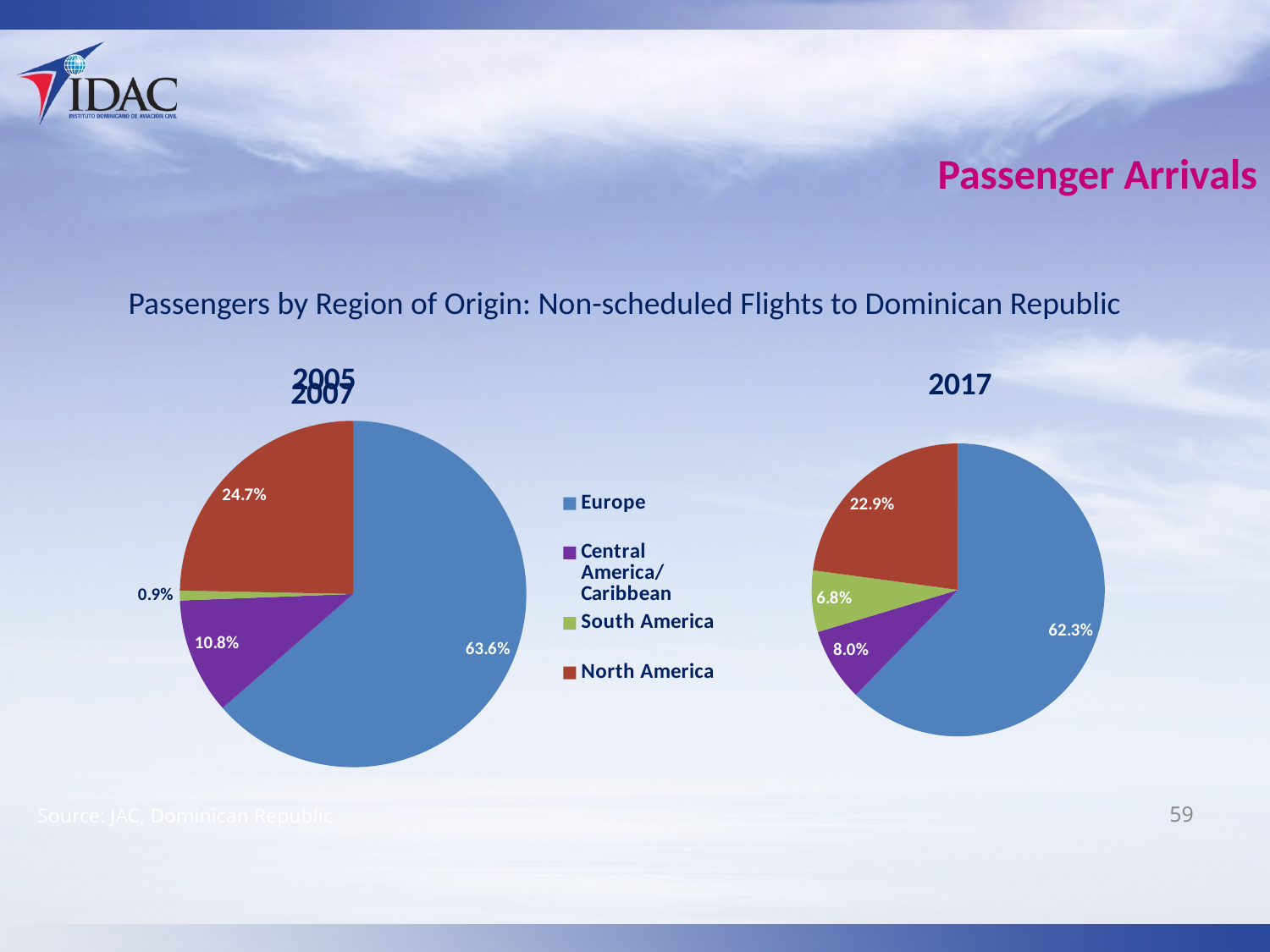
In the 2017 pie chart, what is the value for South America? 6.8% In the 2017 pie chart, which is larger: the share for Central America/Caribbean or the share for South America? Central America/Caribbean In the 2017 pie chart, which region has the largest share? Europe In the 2017 pie chart, which region has the smallest share? South America Which colour represents North America in the pie charts? Red In the left pie chart, what is the value for Central America/Caribbean? 10.8% In the left pie chart, what share of passengers came from Europe? 63.6% In the 2017 pie chart, what share of passengers came from North America? 22.9% What is the difference between the North America share in the left pie chart and in the 2017 pie chart? 1.8 percentage points In the left pie chart, which region has the smallest share? South America How many regions does the legend list? 4 What kind of chart is used to show the 2017 data? Pie chart